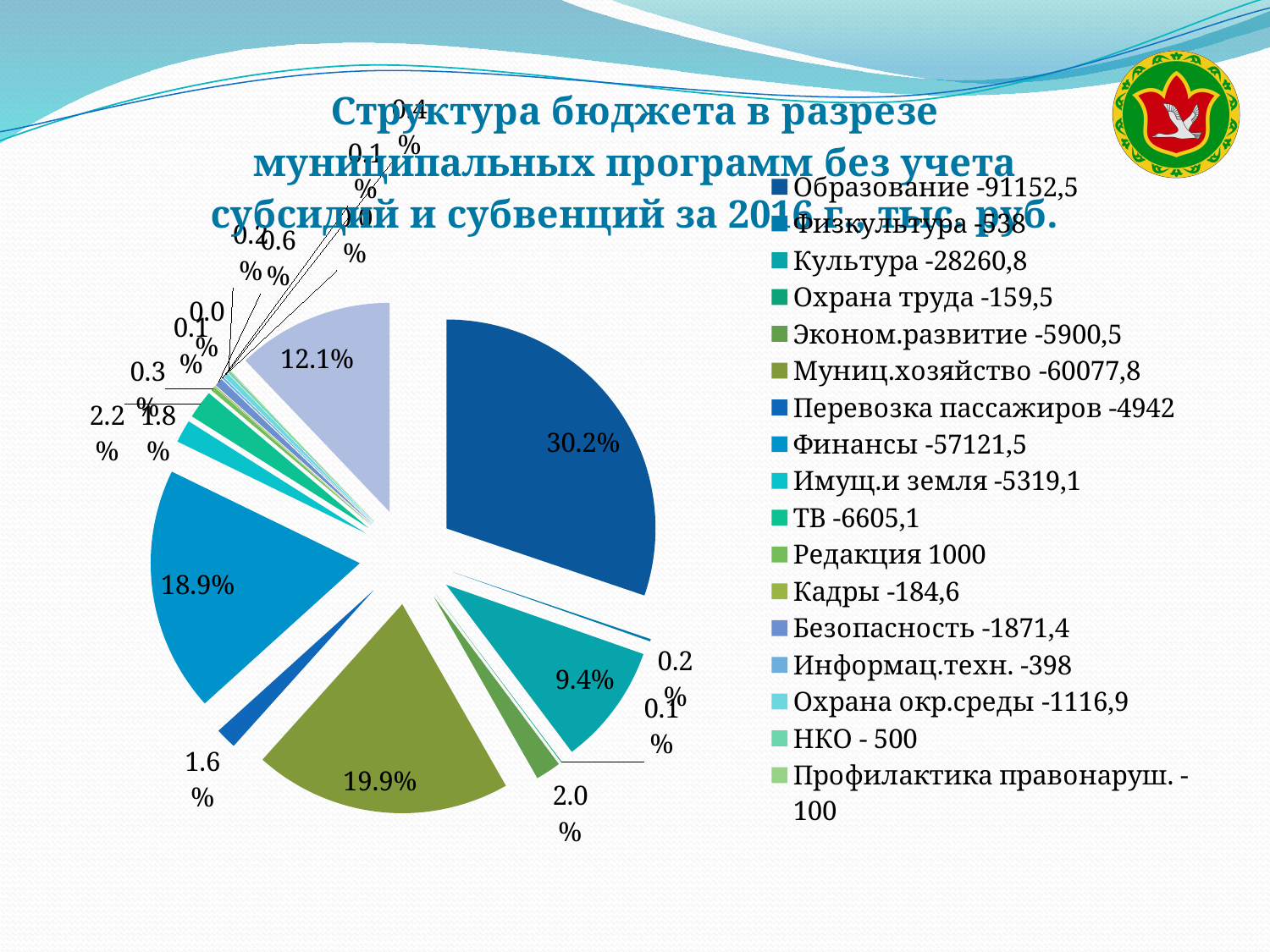
What is the difference in percentage points between the Муниц.хозяйство slice (19.9%) and the Финансы slice (18.9%)? 1.0 What value is given for Культура in the legend? 28260,8 What value is given for Финансы in the legend? 57121,5 What kind of chart is shown on the slide? pie chart Which category has the largest slice of the pie? Образование What percentage share is labelled on the Финансы slice? 18.9% What value is given for Перевозка пассажиров in the legend? 4942 Which has the larger legend value, Финансы or Муниц.хозяйство? Муниц.хозяйство What value is given for Муниц.хозяйство in the legend? 60077,8 What percentage share is labelled on the largest slice (Образование)? 30.2% What percentage share is labelled on the Муниц.хозяйство slice? 19.9% How many entries does the legend list? 17